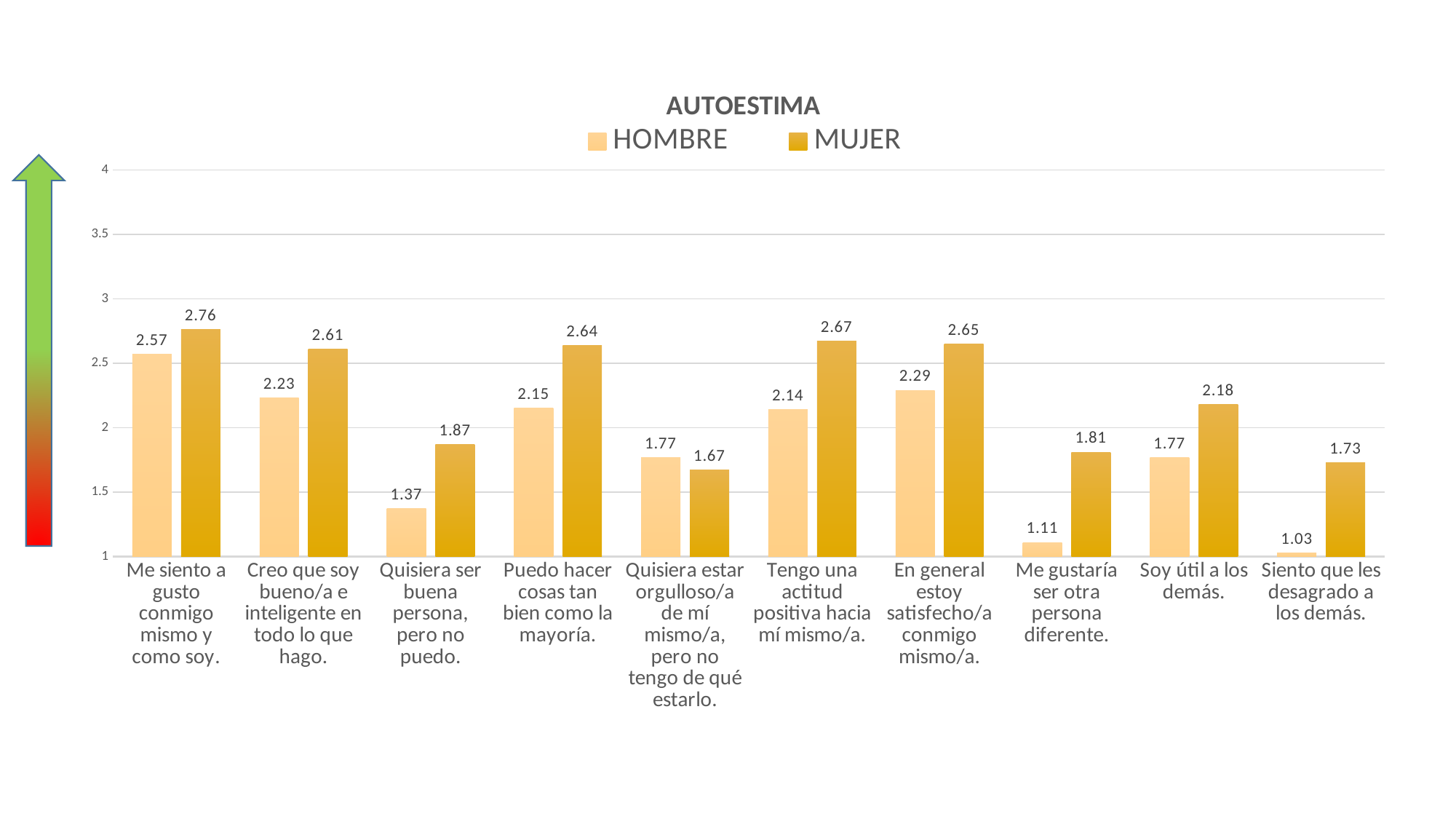
For "Quisiera estar orgulloso/a de mí mismo/a, pero no tengo de qué estarlo.", which is larger, the HOMBRE or the MUJER value? HOMBRE Which category has the highest MUJER value? Me siento a gusto conmigo mismo y como soy. What is the title of the chart? AUTOESTIMA What is the HOMBRE value for "Me siento a gusto conmigo mismo y como soy."? 2.57 How many series does the legend list? 2 Is the MUJER value for "Tengo una actitud positiva hacia mí mismo/a." greater or less than 2.5? greater How many categories are shown on the x axis? 10 What is the difference between the MUJER and HOMBRE values for "Quisiera ser buena persona, pero no puedo."? 0.5 Which category has the lowest HOMBRE value? Siento que les desagrado a los demás. What is the MUJER value for "Soy útil a los demás."? 2.18 What is the HOMBRE value for "Siento que les desagrado a los demás."? 1.03 What kind of chart is shown? Bar chart